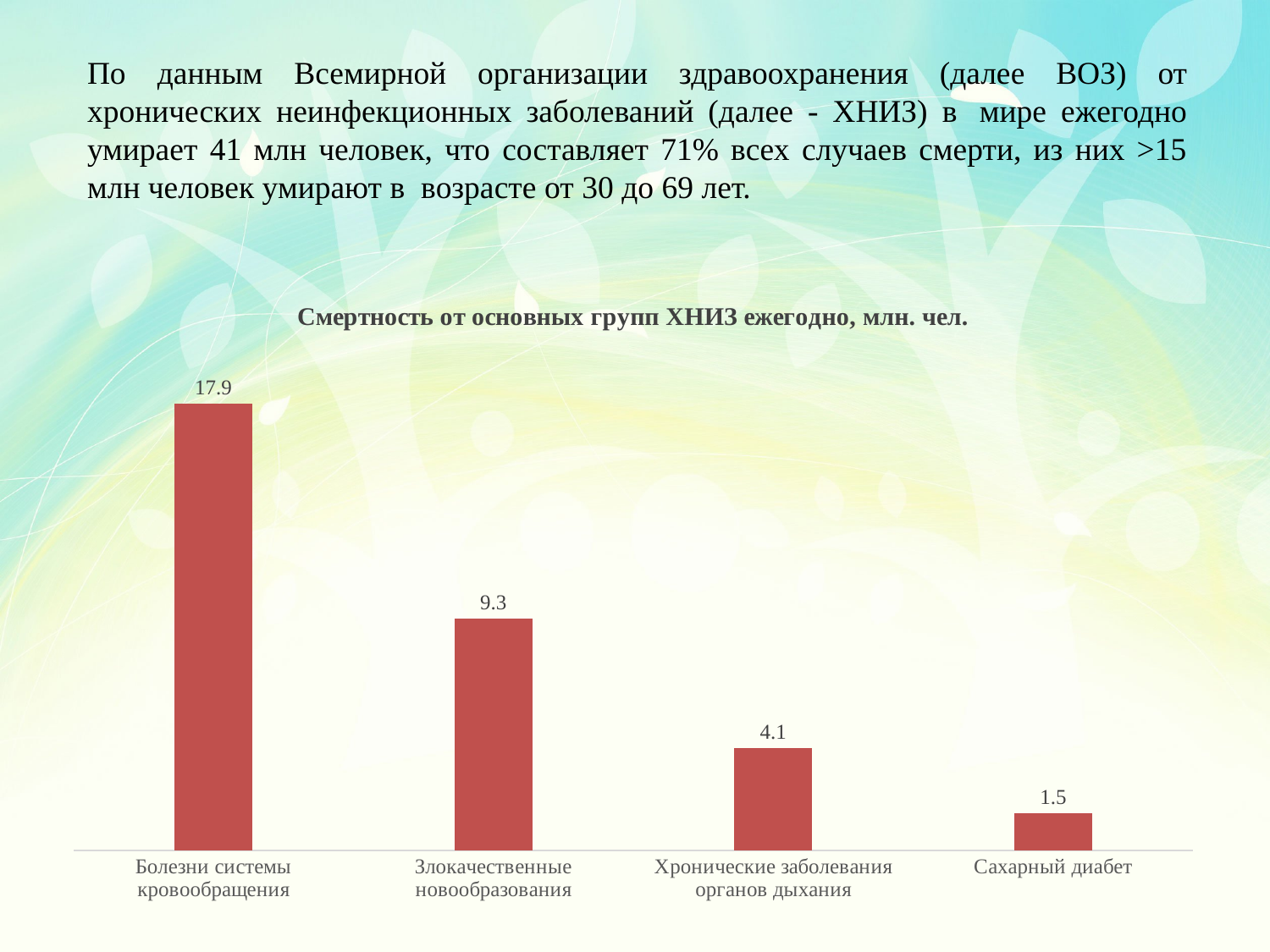
What is the value for Болезни системы кровообращения? 17.9 How many categories are shown in the chart? 4 What is the difference between the values for Болезни системы кровообращения and Злокачественные новообразования? 8.6 What is the title of the chart? Смертность от основных групп ХНИЗ ежегодно, млн. чел. Which category has the lowest value? Сахарный диабет What is the value for Хронические заболевания органов дыхания? 4.1 Which category has the highest value? Болезни системы кровообращения What is the difference between the values for Хронические заболевания органов дыхания and Сахарный диабет? 2.6 What kind of chart is shown on the slide? Bar chart What is the value for Злокачественные новообразования? 9.3 What is the value for Сахарный диабет? 1.5 Which is larger: the value for Злокачественные новообразования or the value for Хронические заболевания органов дыхания? Злокачественные новообразования